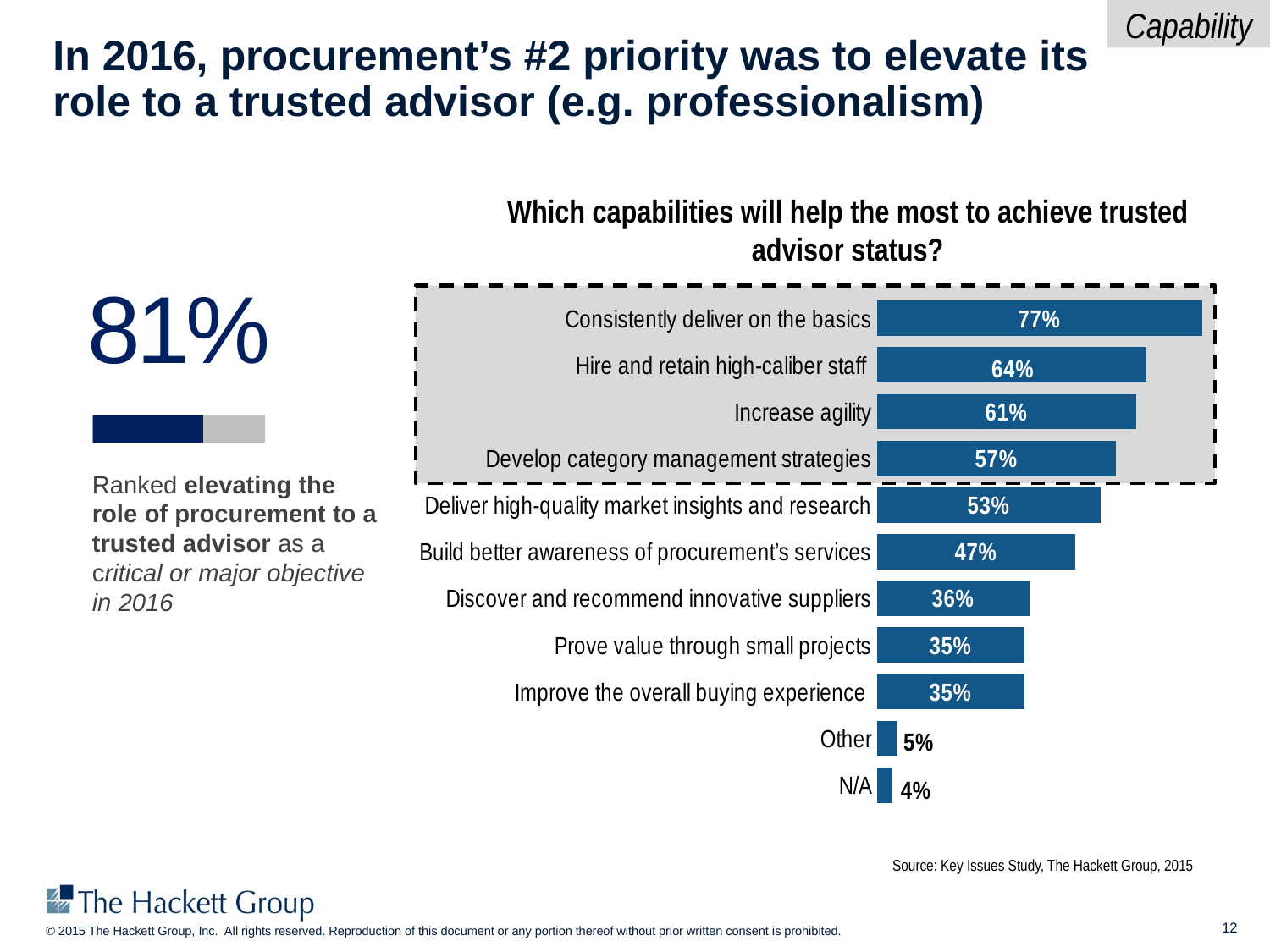
What percentage is shown for "Build better awareness of procurement's services"? 47% Which category has the lowest percentage? N/A What type of chart is used to show the capabilities? Bar chart Which is larger: "Deliver high-quality market insights and research" or "Discover and recommend innovative suppliers"? Deliver high-quality market insights and research What is the difference between "Hire and retain high-caliber staff" and "Develop category management strategies"? 7% What percentage is shown for "Increase agility"? 61% What percentage is shown for "N/A"? 4% Which capability has the highest percentage? Consistently deliver on the basics What is the difference between "Consistently deliver on the basics" and "Other"? 72% What is the title of the chart? Which capabilities will help the most to achieve trusted advisor status? What percentage is shown for "Consistently deliver on the basics"? 77% How many categories are shown in the bar chart? 11